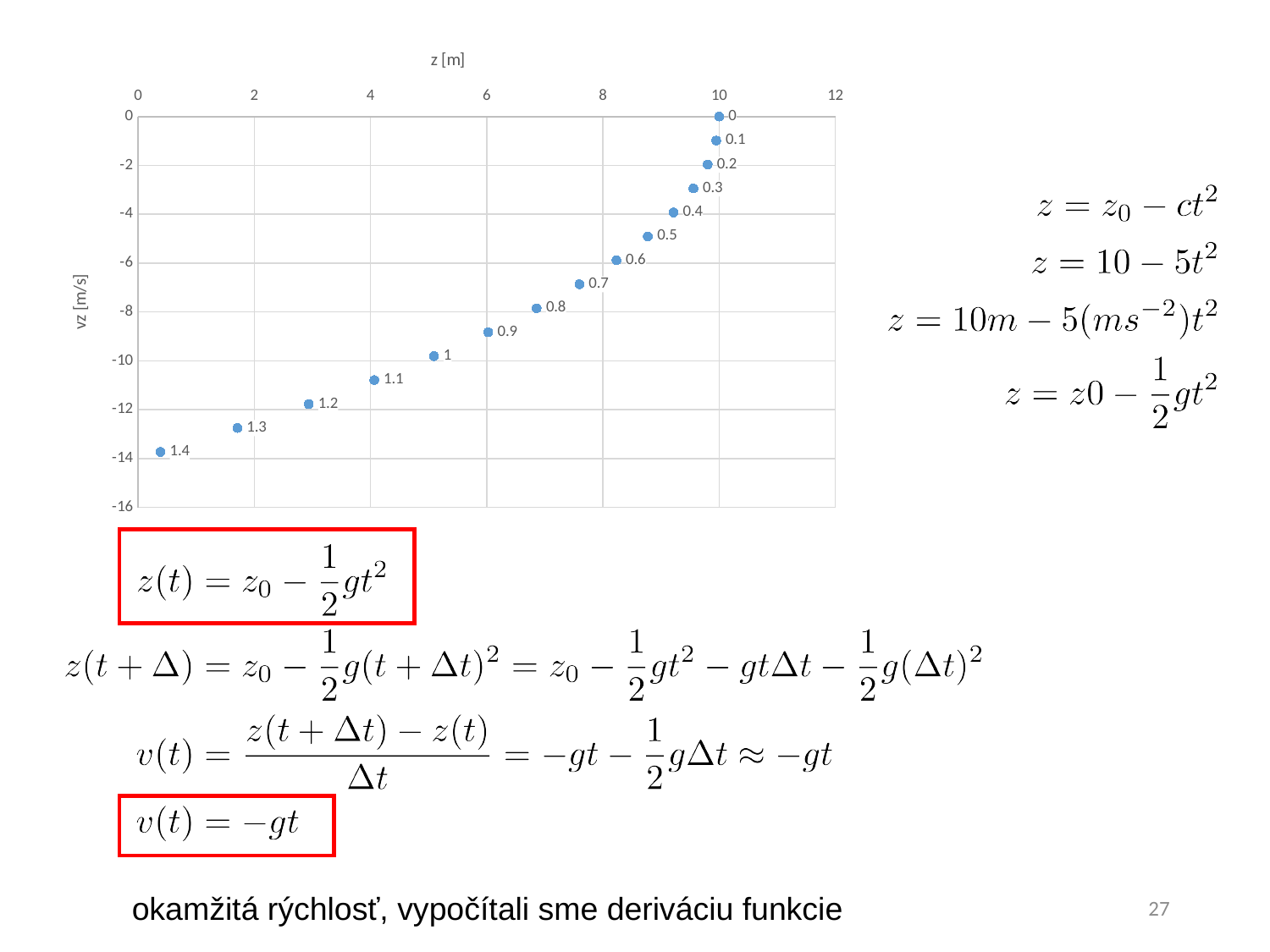
Is the vz value for the point labelled 0.5 greater or less than -6? greater Is the z value for the point labelled 0.7 greater or less than 6? greater Is the z value for the point labelled 1 greater or less than 6? less What is the title of the horizontal axis of the chart? z [m] As z increases along the x axis, does vz rise or fall? rise What is the title of the vertical axis of the chart? vz [m/s] Which labelled point has the highest vz value? 0 Which point has the larger z value, the one labelled 0.3 or the one labelled 1.2? 0.3 Which labelled point has the lowest vz value? 1.4 How many data points are plotted in the chart? 15 What kind of chart is shown on the slide? scatter chart